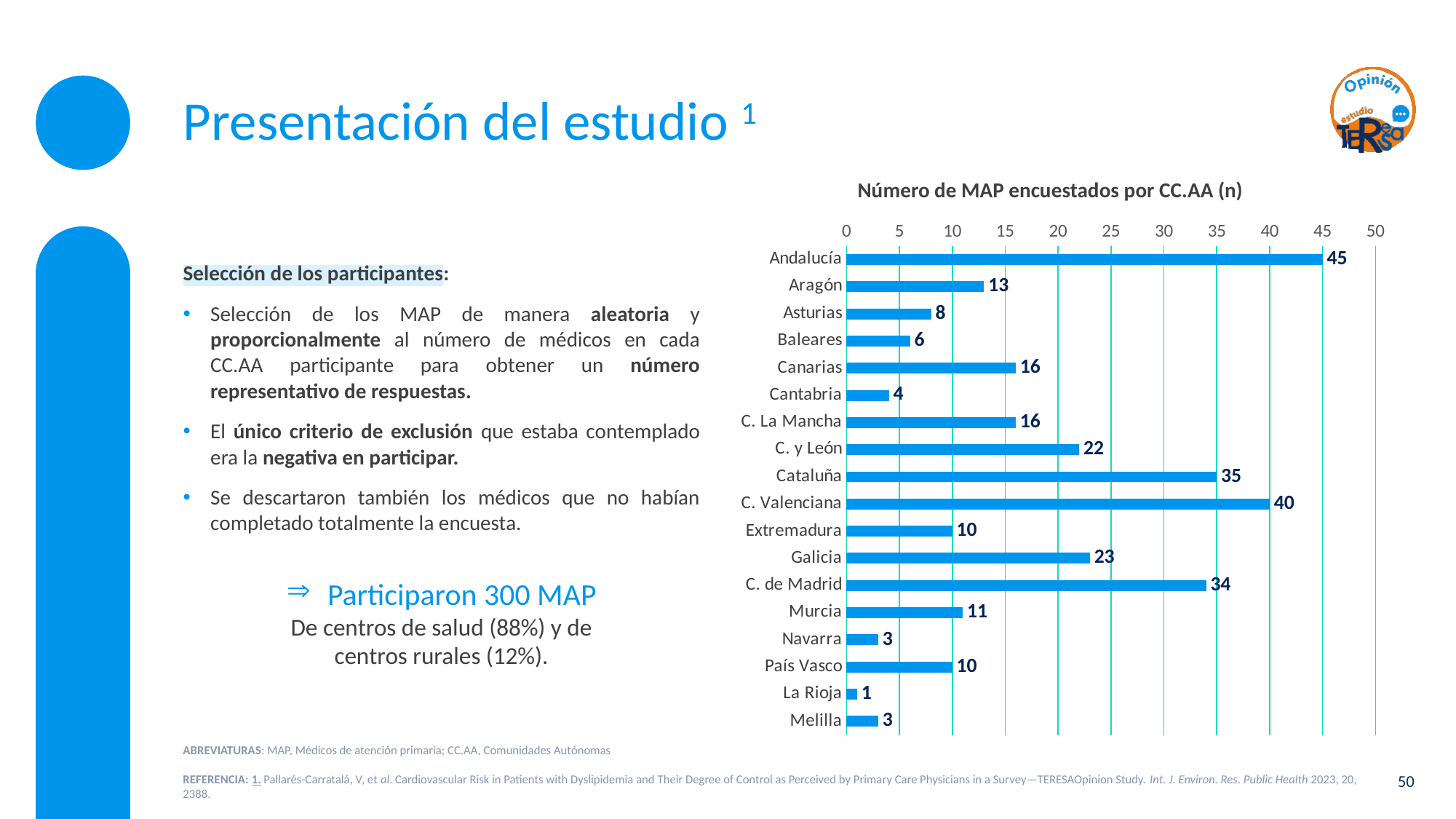
How many categories (CC.AA) are shown in the chart? 18 What is the difference between the values for C. Valenciana and C. de Madrid? 6 How many MAP were surveyed in Cataluña according to the chart? 35 Which is larger, the value for Canarias or the value for Extremadura? Canarias What is the value for Andalucía in the chart? 45 What is the value shown for País Vasco? 10 Which category has the lowest value in the chart? La Rioja Which category has the highest value in the chart? Andalucía What is the difference between the values for Galicia and C. y León? 1 Which is larger, the value for Aragón or the value for Murcia? Aragón What is the title of the chart? Número de MAP encuestados por CC.AA (n) What kind of chart is shown on the slide? Bar chart